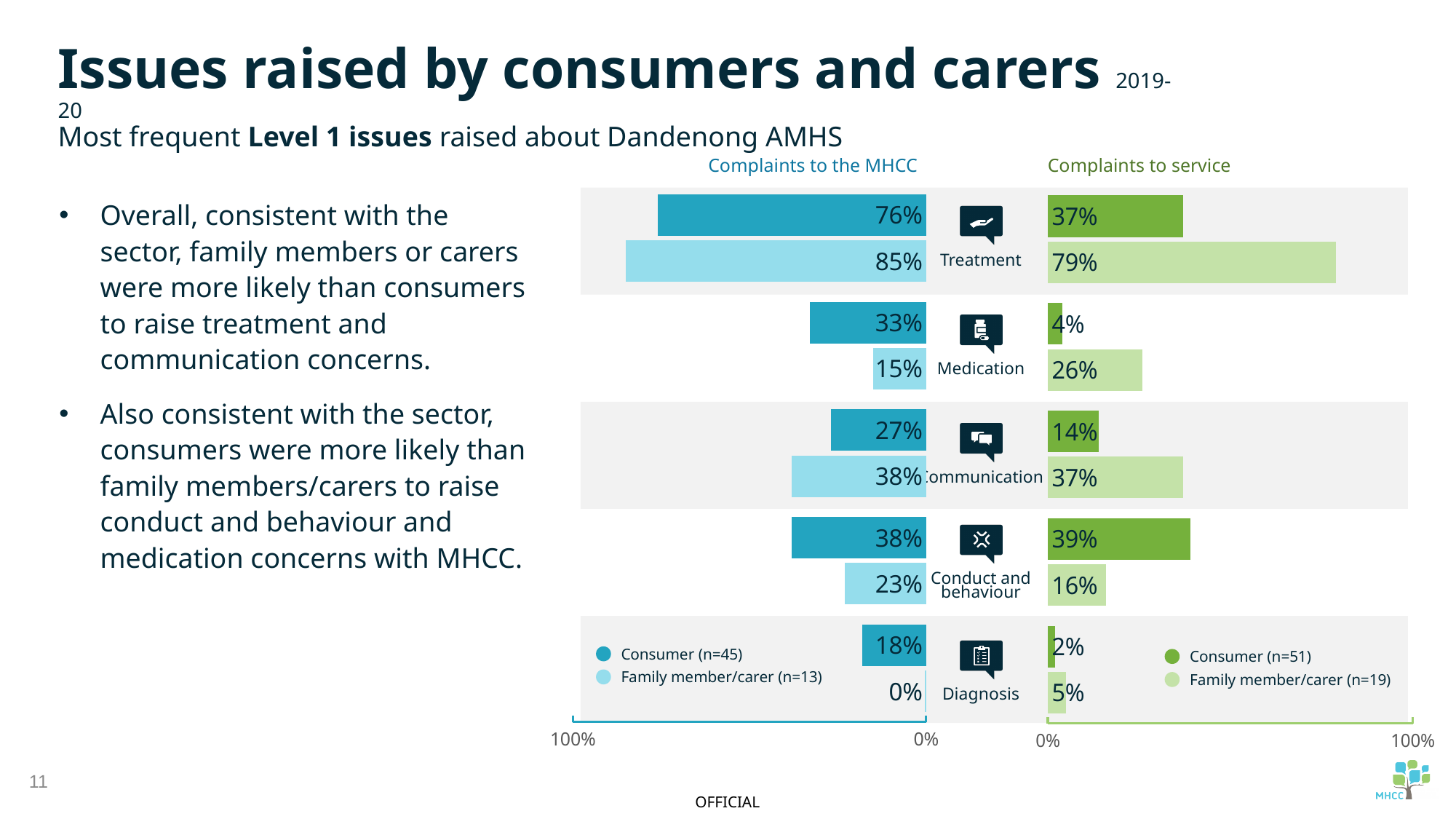
In the 'Complaints to the MHCC' chart, what is the difference between the family member/carer and consumer values for Treatment? 9% In the 'Complaints to the MHCC' chart, what is the value for family member/carer for Diagnosis? 0% What type of chart is the 'Complaints to the MHCC' chart? Bar chart In the 'Complaints to the MHCC' chart, which issue category has the lowest consumer value? Diagnosis In the 'Complaints to service' chart, what percentage of family members/carers raised Treatment issues? 79% In the 'Complaints to the MHCC' chart, which is larger for Conduct and behaviour: the consumer value or the family member/carer value? Consumer How many series does the legend of the 'Complaints to service' chart list? 2 How many issue categories are shown in the 'Complaints to the MHCC' chart? 5 In the 'Complaints to service' chart, which is larger for Communication: the consumer value or the family member/carer value? Family member/carer In the 'Complaints to service' chart, which issue category has the highest consumer value? Conduct and behaviour In the 'Complaints to service' chart, what is the difference between the family member/carer and consumer values for Medication? 22% In the 'Complaints to the MHCC' chart, what percentage of consumers raised Treatment issues? 76%